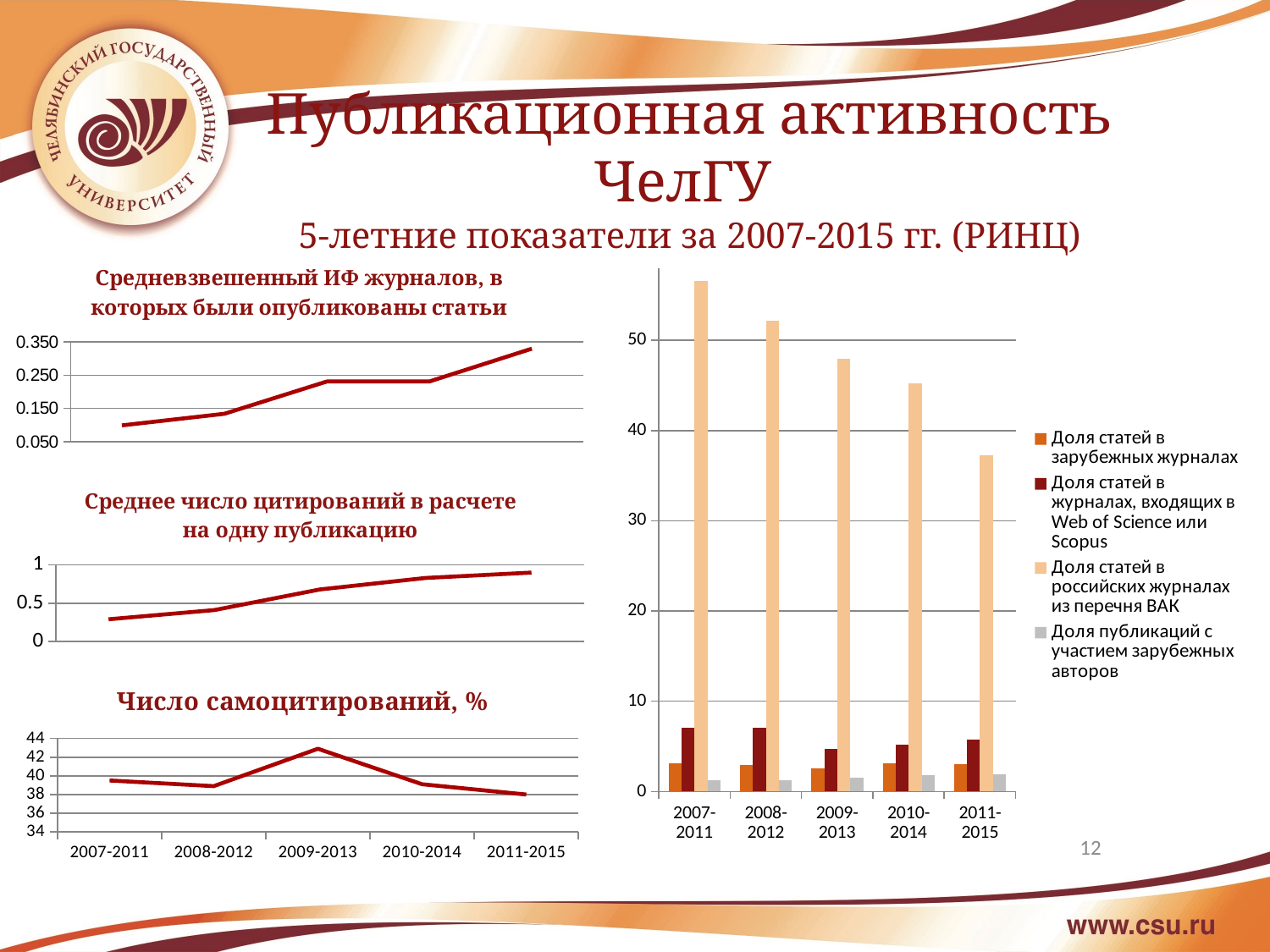
In the bar chart on the right, which series has the tallest bars in every period? Доля статей в российских журналах из перечня ВАК How many series does the legend of the bar chart on the right list? 4 In the bar chart on the right, for 2007-2011, which is larger: 'Доля статей в зарубежных журналах' or 'Доля статей в журналах, входящих в Web of Science или Scopus'? Доля статей в журналах, входящих в Web of Science или Scopus In the chart 'Среднее число цитирований в расчете на одну публикацию', is the value for 2007-2011 greater or less than 0.5? less What kind of chart is the chart on the right side of the slide? bar chart In the chart 'Число самоцитирований, %', which period has the highest value? 2009-2013 In the bar chart on the right, is the value for 'Доля статей в российских журналах из перечня ВАК' in 2007-2011 greater or less than 50? greater In the chart 'Средневзвешенный ИФ журналов, в которых были опубликованы статьи', does the line rise or fall from 2007-2011 to 2011-2015? rise How many periods are shown on the x axis of the bar chart on the right? 5 In the bar chart on the right, is the value for 'Доля статей в российских журналах из перечня ВАК' in 2011-2015 greater or less than 40? less In the bar chart on the right, do the values for 'Доля статей в российских журналах из перечня ВАК' rise or fall from 2007-2011 to 2011-2015? fall What kind of chart is 'Число самоцитирований, %'? line chart